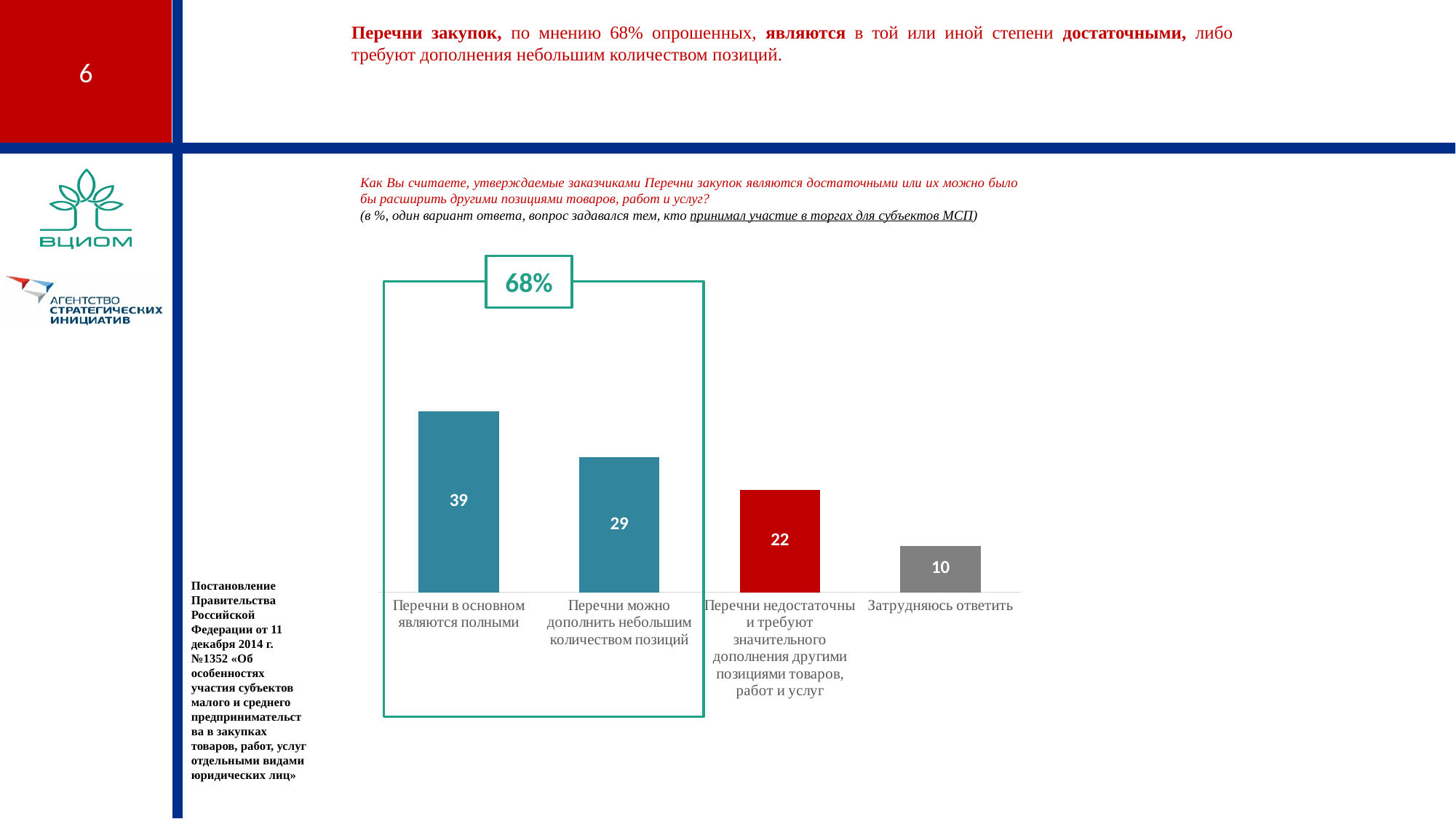
What is the value for "Перечни в основном являются полными"? 39 What is the value for "Затрудняюсь ответить"? 10 Which is larger: the value for "Перечни недостаточны и требуют значительного дополнения другими позициями товаров, работ и услуг" or the value for "Затрудняюсь ответить"? Перечни недостаточны и требуют значительного дополнения другими позициями товаров, работ и услуг What is the value for "Перечни можно дополнить небольшим количеством позиций"? 29 Which category has the highest value? Перечни в основном являются полными How many categories are shown in the chart? 4 What percentage is shown in the box above the first two bars? 68% What kind of chart is shown on the slide? Bar chart What is the value for "Перечни недостаточны и требуют значительного дополнения другими позициями товаров, работ и услуг"? 22 Which category has the lowest value? Затрудняюсь ответить What is the difference between the values for "Перечни в основном являются полными" and "Перечни можно дополнить небольшим количеством позиций"? 10 Do the values rise or fall from left to right across the categories? Fall